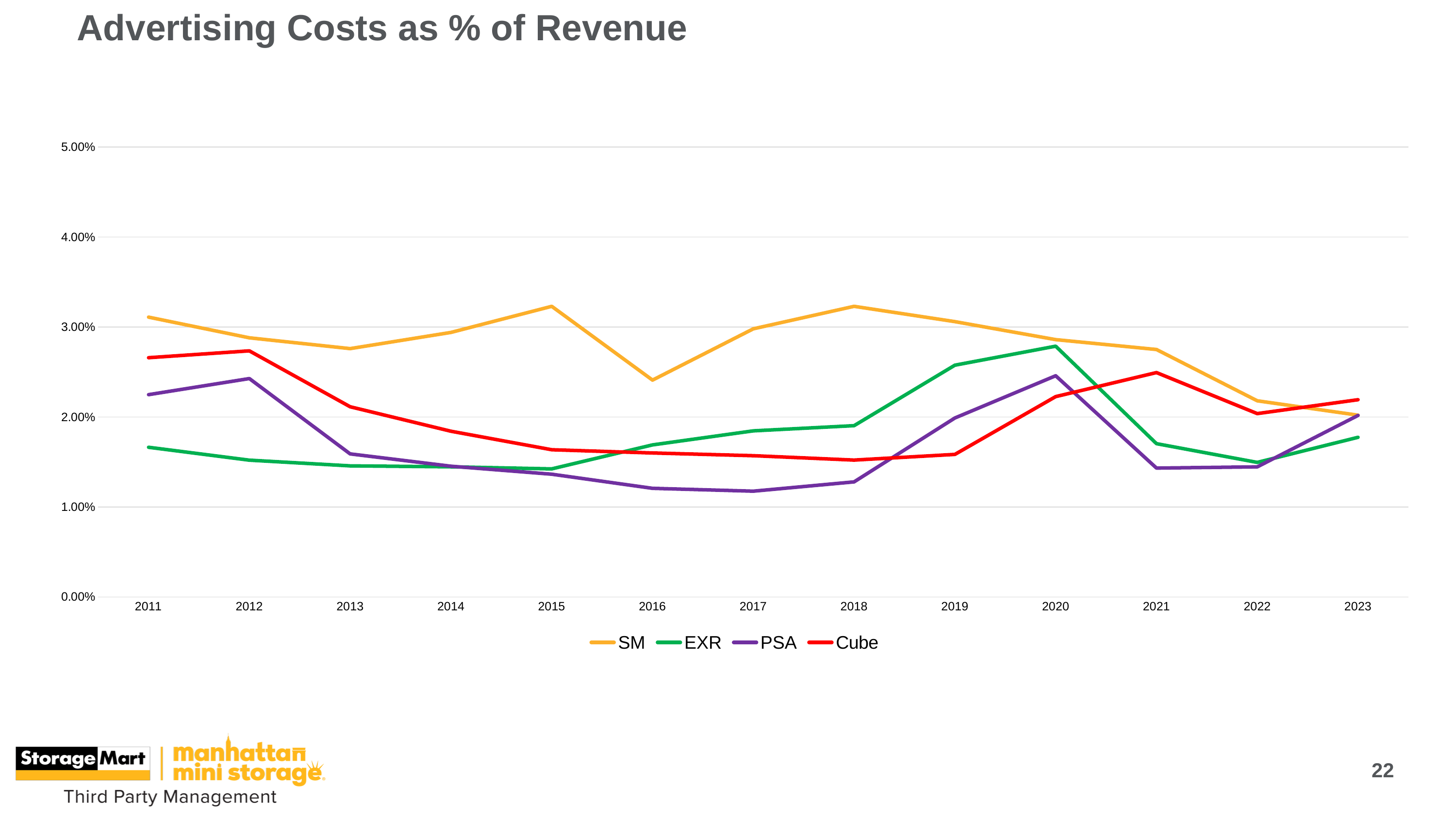
Is the value for EXR in 2020 greater or less than 2.00%? greater Does the SM line rise or fall from 2018 to 2023? fall In which year does EXR reach its highest value? 2020 Which series has the highest value in 2015? SM Is the value for PSA in 2017 greater or less than 1.00%? greater What type of chart is shown on the slide? line chart In 2021, which is higher, Cube or EXR? Cube How many years are plotted along the x axis? 13 Which series has the lowest value in 2017? PSA How many series does the legend list? 4 Is the value for SM in 2016 greater or less than 3.00%? less